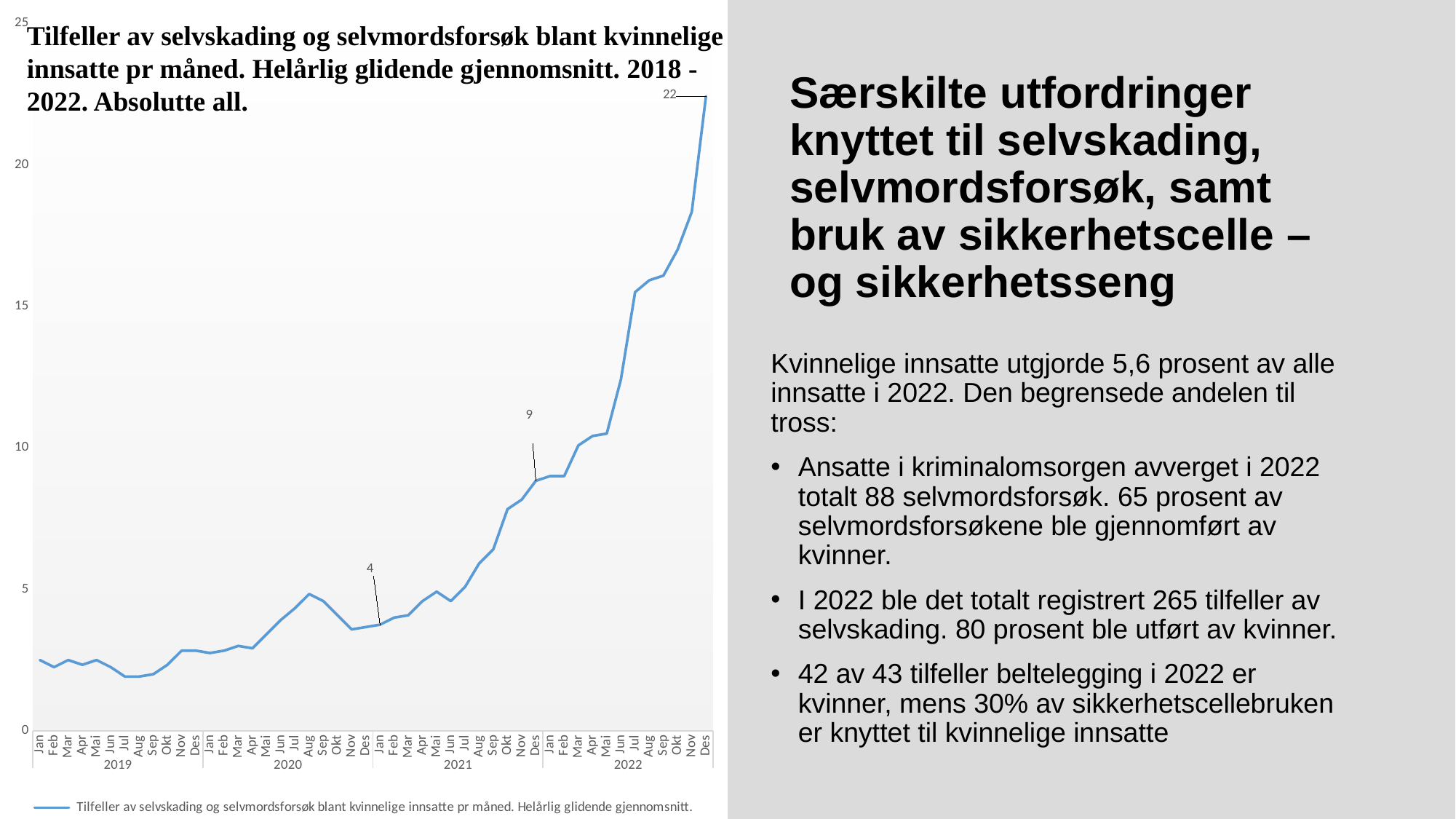
What is the difference between the labelled values for Des 2022 and Des 2021? 13 Is the value for Jan 2019 greater or less than 5? less What is the difference between the labelled values for Des 2021 and Jan 2021? 5 What type of chart is shown on the slide? line chart Which is larger, the value for Des 2022 or the value for Des 2021? Des 2022 Which month has the highest value on the chart? Des 2022 What is the labelled value for Des 2022? 22 Is the value for Okt 2022 greater or less than 15? greater Do the values generally rise or fall from Jan 2019 to Des 2022? rise What is the labelled value for Jan 2021? 4 What is the labelled value for Des 2021? 9 How many series does the legend list? 1